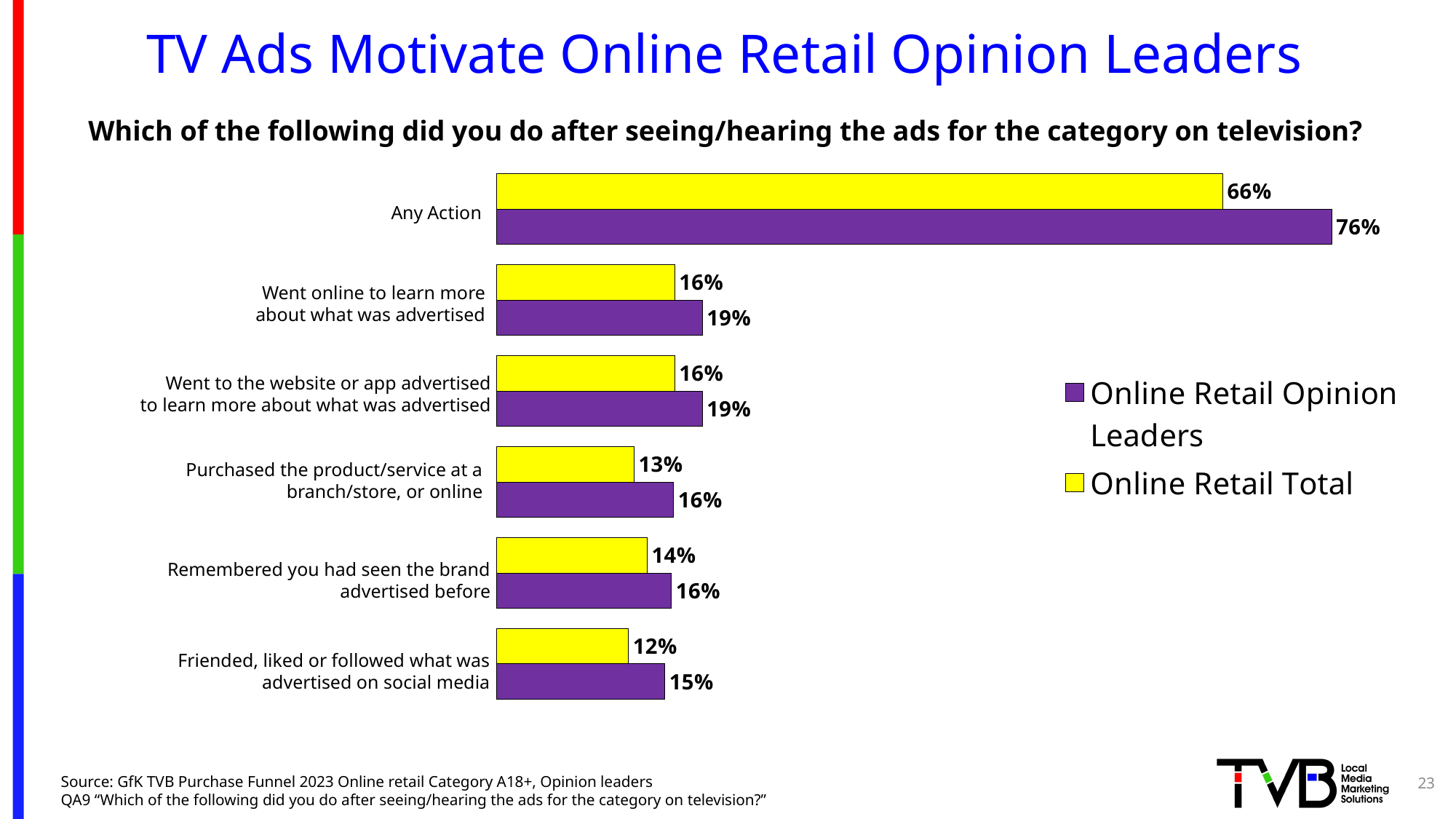
What is the value for Online Retail Total for 'Remembered you had seen the brand advertised before'? 14% What is the value for Online Retail Opinion Leaders for 'Purchased the product/service at a branch/store, or online'? 16% For 'Went online to learn more about what was advertised', which series has the larger value: Online Retail Opinion Leaders or Online Retail Total? Online Retail Opinion Leaders Which category has the lowest value for Online Retail Total? Friended, liked or followed what was advertised on social media What is the value for Online Retail Opinion Leaders for Any Action? 76% Which category has the highest value for Online Retail Opinion Leaders? Any Action What is the value for Online Retail Total for 'Friended, liked or followed what was advertised on social media'? 12% How many series does the legend list? 2 How many categories are shown in the chart? 6 What is the difference between Online Retail Opinion Leaders and Online Retail Total for Any Action? 10% What is the value for Online Retail Total for Any Action? 66% What kind of chart is shown on the slide? Bar chart